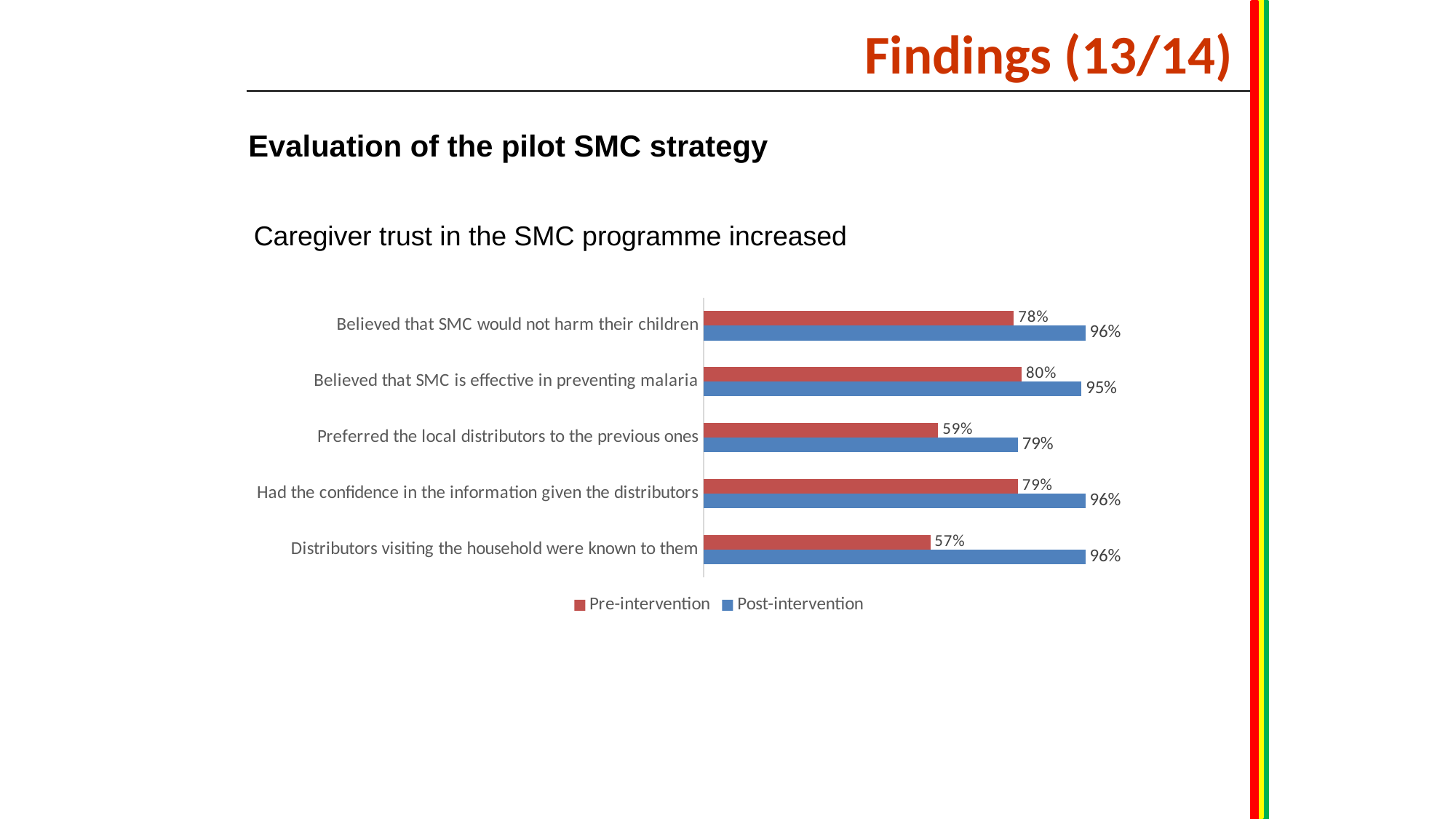
How many series does the legend list? 2 Which category has the highest Pre-intervention value? Believed that SMC is effective in preventing malaria What is the Post-intervention value for 'Believed that SMC is effective in preventing malaria'? 95% Which category has the lowest Post-intervention value? Preferred the local distributors to the previous ones What is the difference between the Post-intervention and Pre-intervention values for 'Preferred the local distributors to the previous ones'? 20% What is the Pre-intervention value for 'Distributors visiting the household were known to them'? 57% Which category has the lowest Pre-intervention value? Distributors visiting the household were known to them What is the Post-intervention value for 'Preferred the local distributors to the previous ones'? 79% How many categories are shown in the chart? 5 Which is larger for 'Had the confidence in the information given the distributors': the Pre-intervention or Post-intervention value? Post-intervention What is the Pre-intervention value for 'Believed that SMC would not harm their children'? 78% What is the difference between the Post-intervention and Pre-intervention values for 'Distributors visiting the household were known to them'? 39%